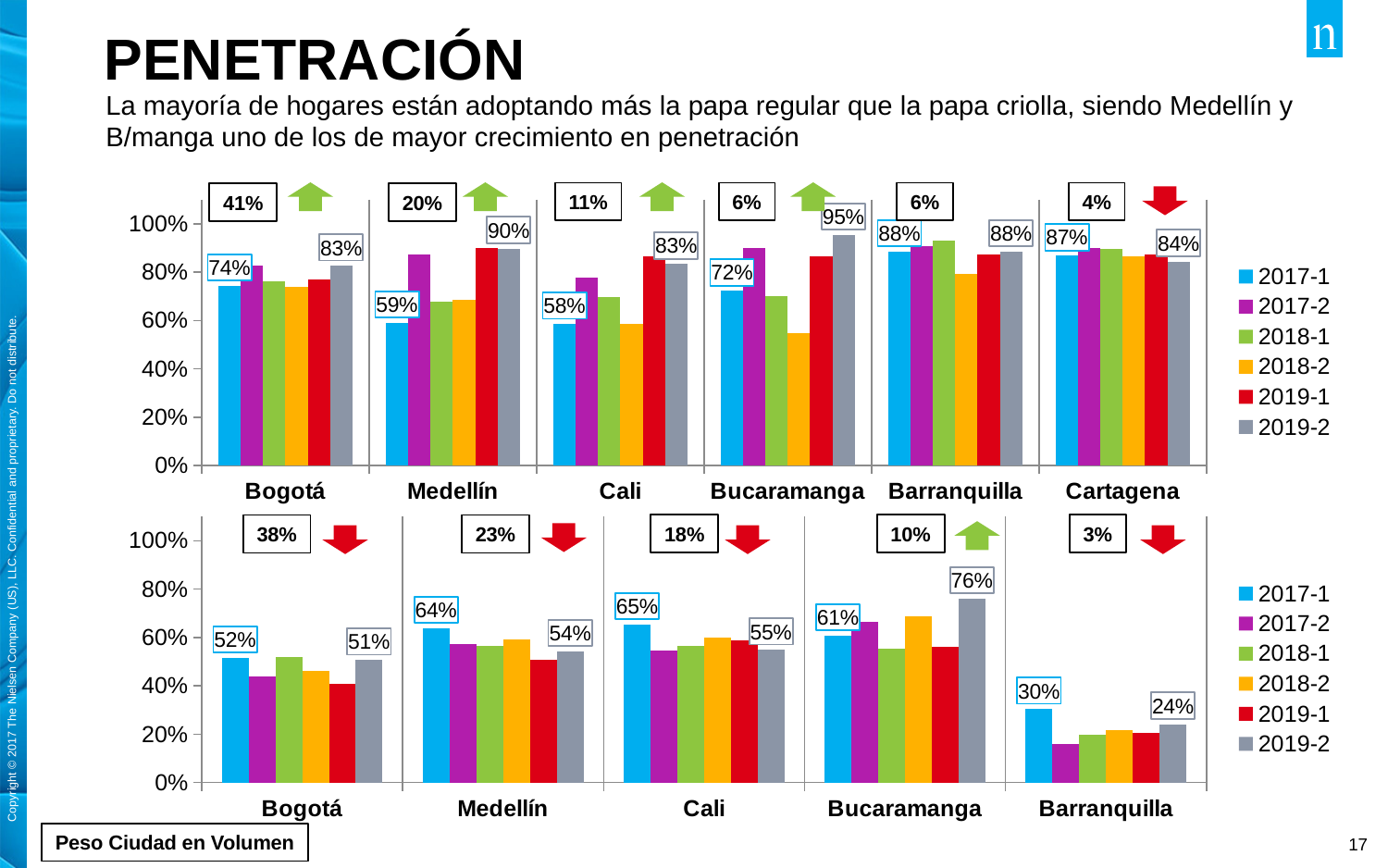
How many series does the legend of the top chart list? 6 In the bottom chart, what is the 2019-2 value for Barranquilla? 24% In the bottom chart, which is larger for Medellín: the 2017-1 value or the 2019-2 value? 2017-1 In the bottom chart, is the 2018-2 value for Bucaramanga greater or less than 60%? greater What type of chart is the top chart? Bar chart In the top chart, what is the 2019-2 value for Bucaramanga? 95% In the bottom chart, what is the 2017-1 value for Cali? 65% In the top chart, which city has the highest labelled 2019-2 value? Bucaramanga How many cities are shown on the x axis of the bottom chart? 5 In the top chart, what is the 2017-1 value for Bogotá? 74% In the bottom chart, which city has the lowest labelled 2017-1 value? Barranquilla In the top chart, what is the difference between Medellín's 2019-2 value and its 2017-1 value? 31 percentage points